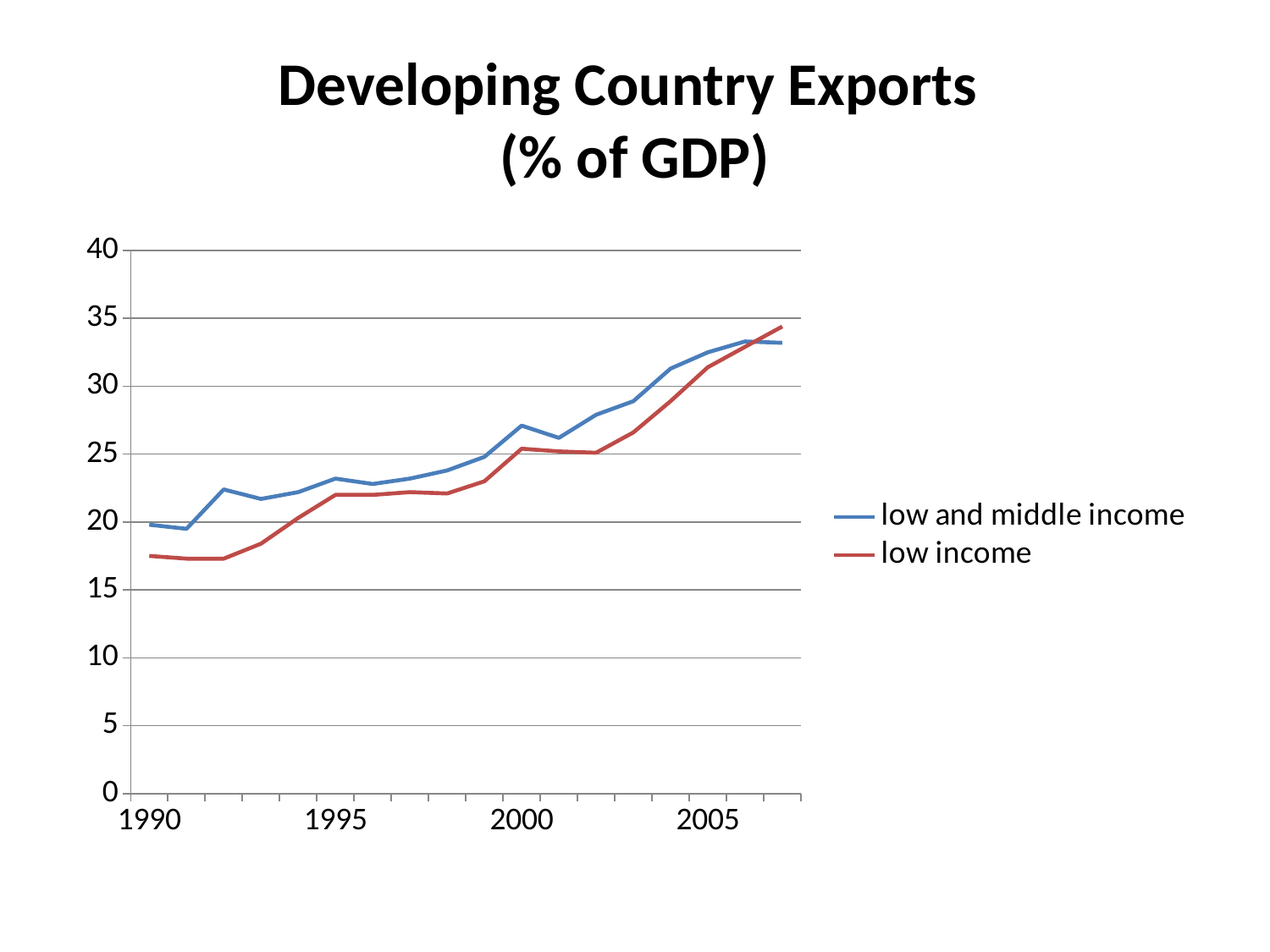
In 1990, which series has the higher value, low and middle income or low income? low and middle income What kind of chart is shown on the slide? line chart Is the value for low income in 2007 greater or less than 30? greater How many series does the legend list? 2 Is the value for low income in 1990 greater or less than 20? less Is the value for low income in 2005 greater or less than 30? greater Which colour is used for the low income series? red Do the values for low income generally rise or fall from 1990 to 2007? rise What is the title of the chart? Developing Country Exports (% of GDP) In 2003, which series has the higher value, low and middle income or low income? low and middle income